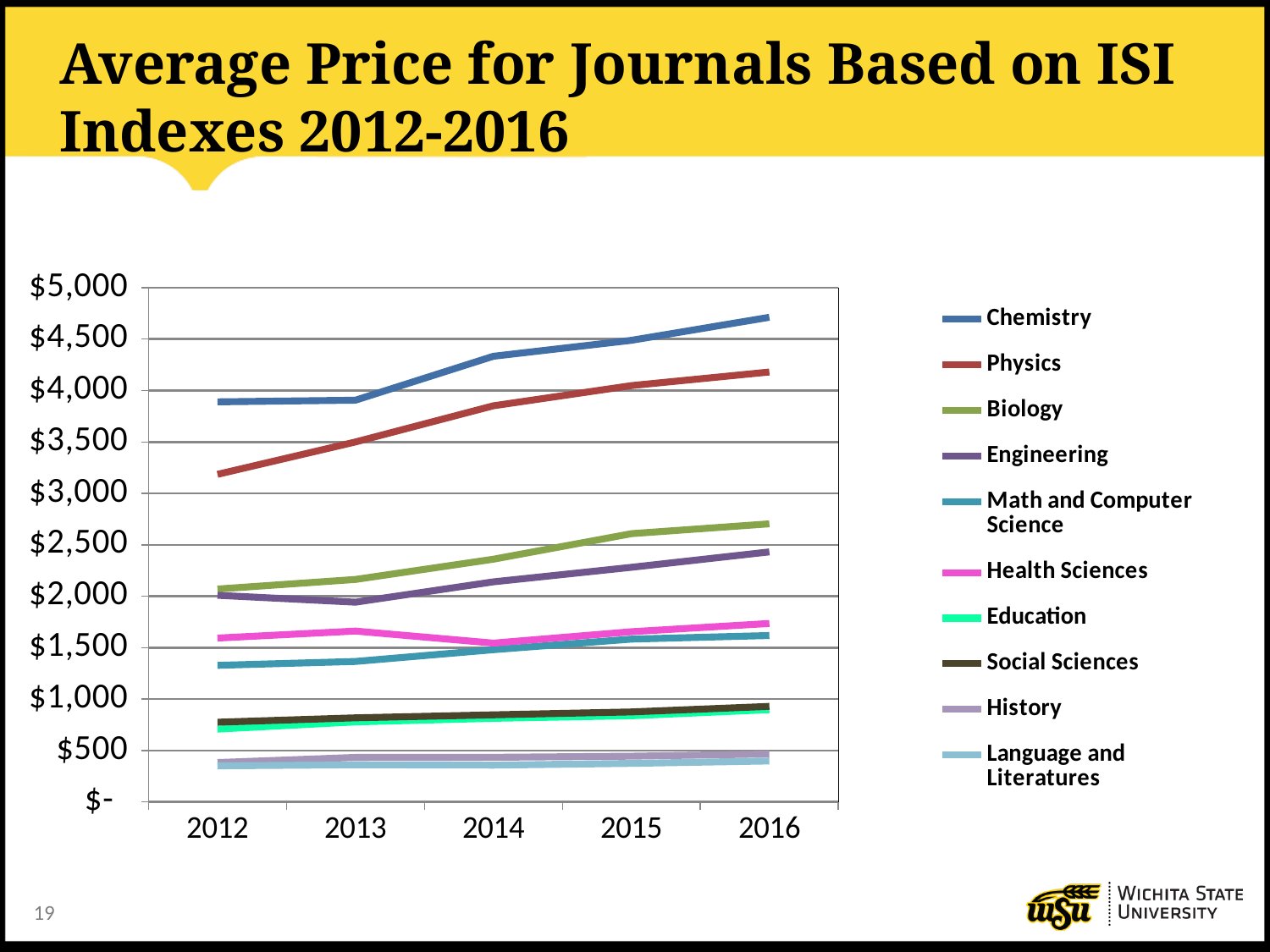
How many years are shown on the x axis? 5 What kind of chart is shown on the slide? line chart In 2016, which is larger, Biology or Engineering? Biology Is the value for Physics in 2012 greater or less than $3,500? less How many series does the legend list? 10 Is the value for Chemistry in 2016 greater or less than $4,500? greater Is the value for Social Sciences in 2016 greater or less than $1,000? less Does the Chemistry line rise or fall from 2012 to 2016? rise What is the title of the slide? Average Price for Journals Based on ISI Indexes 2012-2016 Which series has the highest average price in 2016? Chemistry Which series has the highest average price in 2012? Chemistry In 2013, which is larger, Health Sciences or Math and Computer Science? Health Sciences